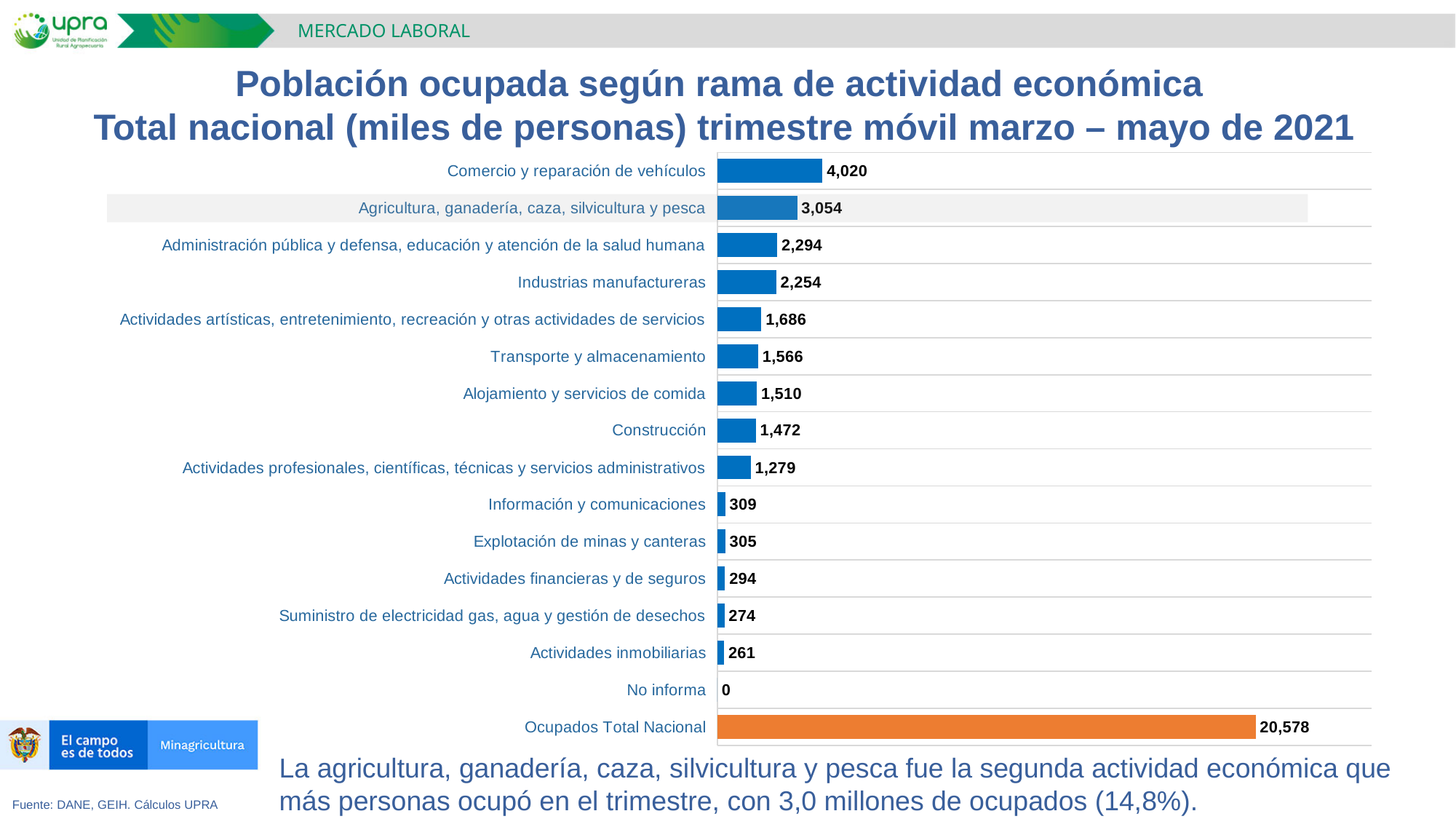
Which economic activity (excluding the national total) has the highest value? Comercio y reparación de vehículos What is the value for Comercio y reparación de vehículos? 4,020 What is the difference between Comercio y reparación de vehículos and Agricultura, ganadería, caza, silvicultura y pesca? 966 What is the difference between Administración pública y defensa, educación y atención de la salud humana and Industrias manufactureras? 40 What is the value shown for Ocupados Total Nacional? 20,578 What kind of chart is shown on the slide? Bar chart What is the value for Construcción? 1,472 Which category has the lowest value? No informa What colour is the bar for Ocupados Total Nacional? Orange Which is larger, Transporte y almacenamiento or Alojamiento y servicios de comida? Transporte y almacenamiento What is the value for Agricultura, ganadería, caza, silvicultura y pesca? 3,054 How many categories (bars) are shown in the chart, including the national total? 16